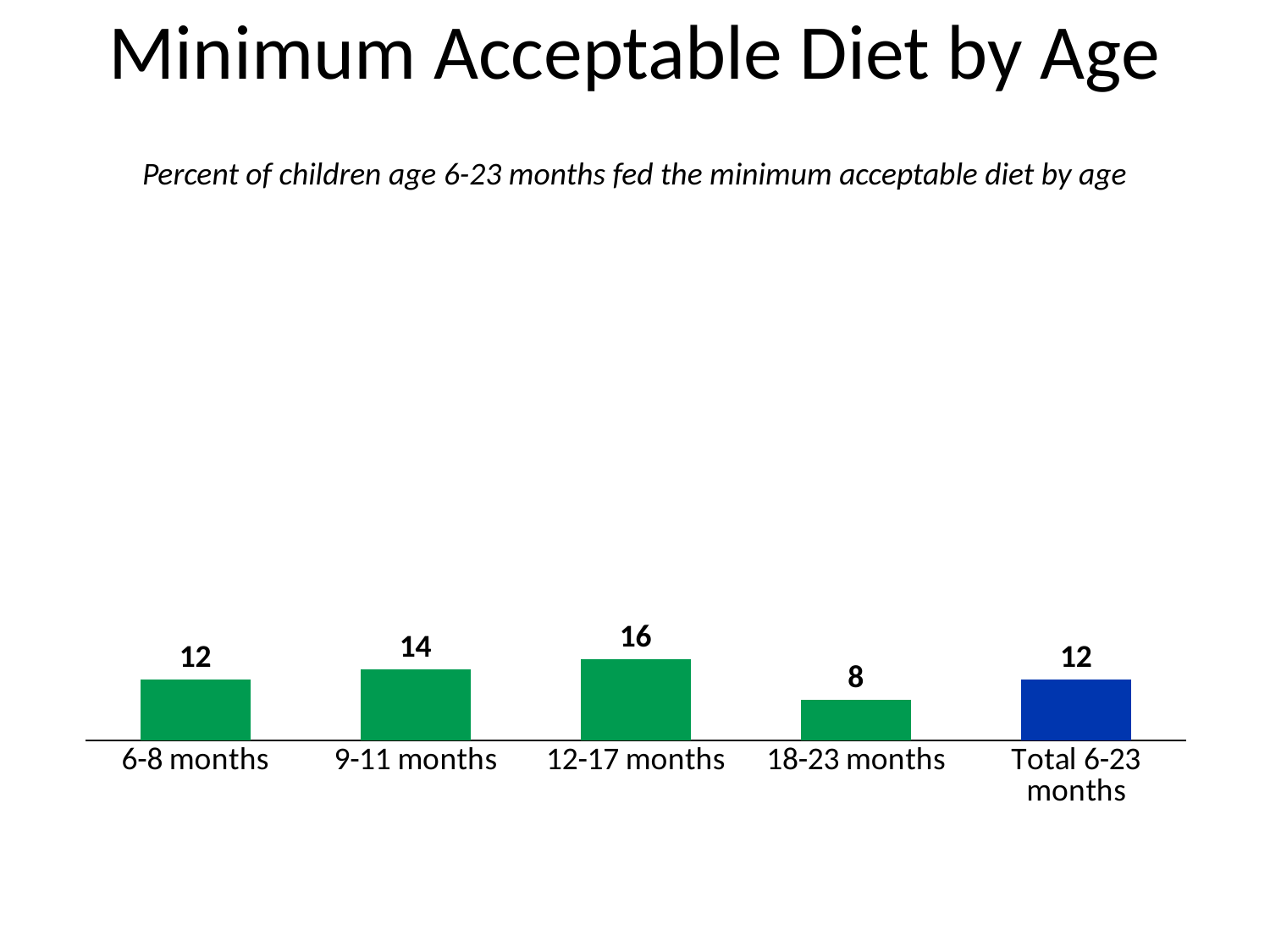
What is the value for 12-17 months? 16 What is the value for 9-11 months? 14 Which age group has the lowest value? 18-23 months What is the value for Total 6-23 months? 12 Which is larger, the value for 9-11 months or the value for 18-23 months? 9-11 months What is the value for 18-23 months? 8 What kind of chart is shown on the slide? bar chart Which age group has the highest value? 12-17 months What is the difference between the values for 12-17 months and 18-23 months? 8 What is the value for 6-8 months? 12 How many bars are shown in the chart? 5 What is the title of the slide? Minimum Acceptable Diet by Age